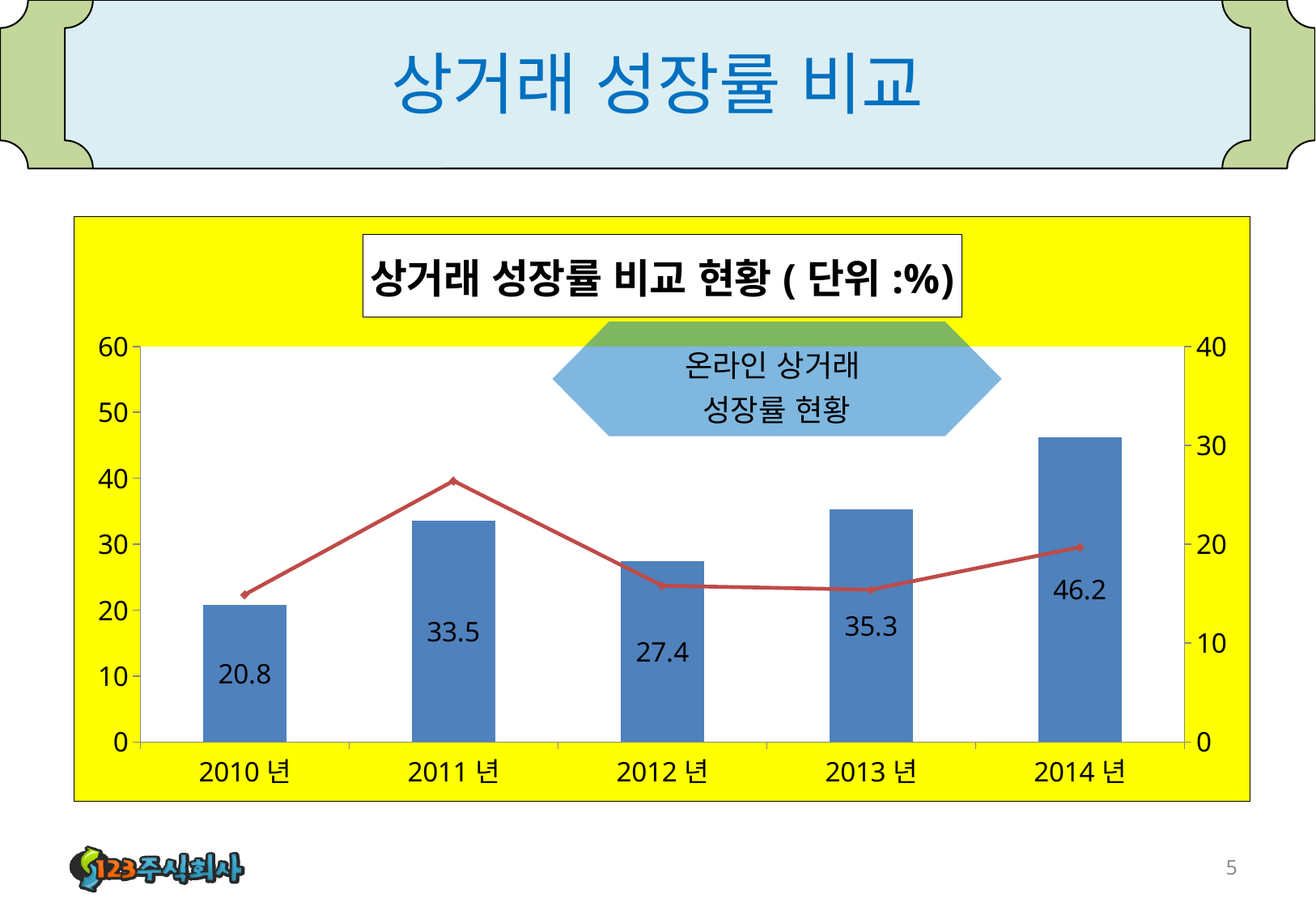
Which has a larger bar value, 2011 년 or 2012 년? 2011 년 On the right-hand axis, is the value of the red line point for 2011 년 greater or less than 20? greater What is the value of the bar for 2014 년? 46.2 What is the value of the bar for 2012 년? 27.4 What kind of chart is shown on the slide? A bar chart combined with a line chart How many years are shown on the x axis? 5 What is the title of the chart? 상거래 성장률 비교 현황 ( 단위 :%) On the right-hand axis, is the value of the red line point for 2010 년 greater or less than 20? less What is the value of the bar for 2011 년? 33.5 What is the difference between the bar values for 2014 년 and 2013 년? 10.9 Which year has the lowest bar value? 2010 년 Which year has the highest bar value? 2014 년